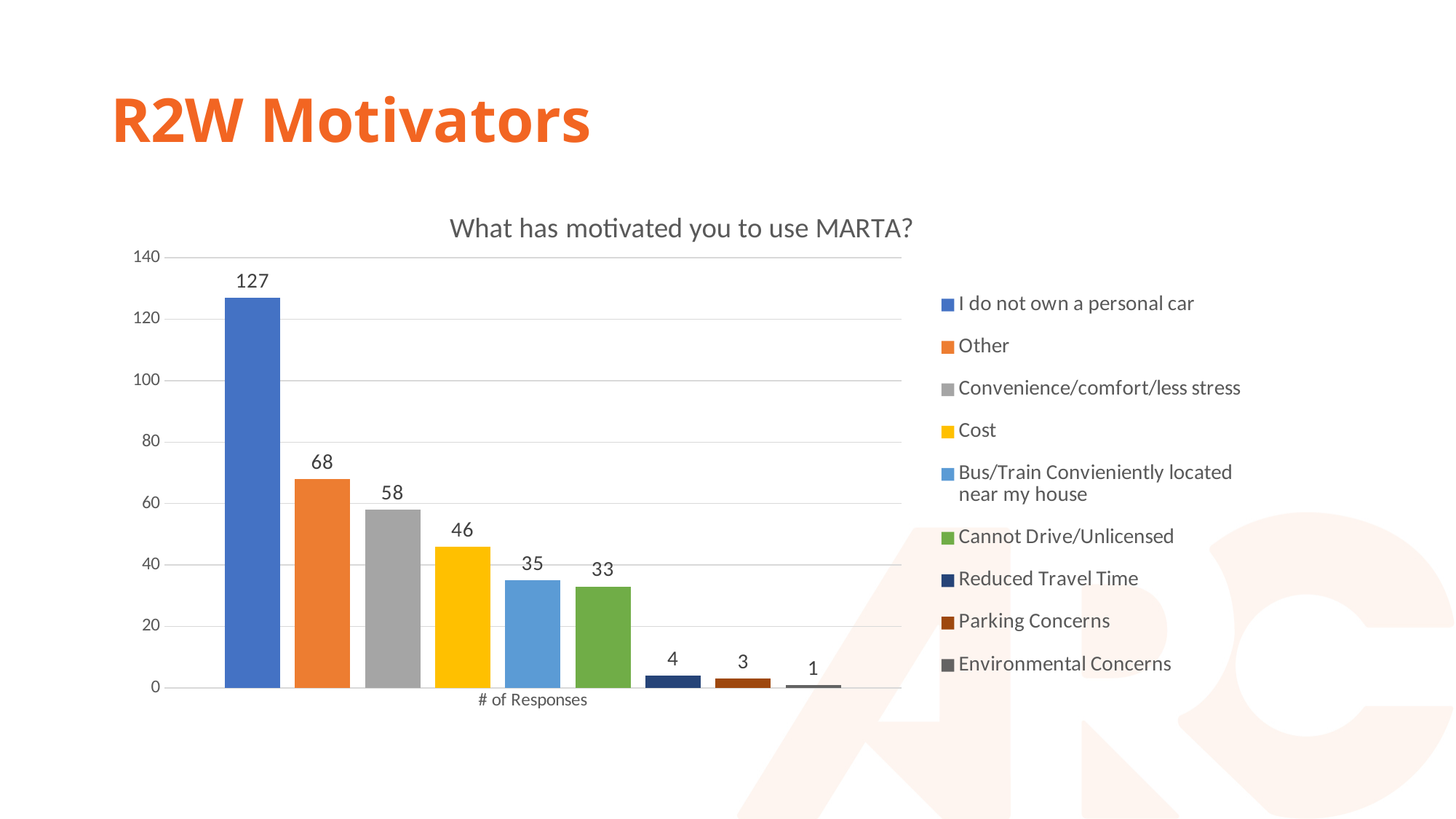
How many entries does the legend list? 9 Which motivator received the fewest responses? Environmental Concerns Is the value for "Other" greater or less than 60? greater What is the number of responses for "Cost"? 46 How many responses does "Cannot Drive/Unlicensed" have? 33 What is the difference in responses between "Other" and "Convenience/comfort/less stress"? 10 What is the title of the chart? What has motivated you to use MARTA? Which motivator received the most responses? I do not own a personal car How many motivator categories are plotted in the chart? 9 Which has more responses, "Bus/Train Convieniently located near my house" or "Cannot Drive/Unlicensed"? Bus/Train Convieniently located near my house What type of chart is shown on the slide? Bar chart How many responses were given for "I do not own a personal car"? 127